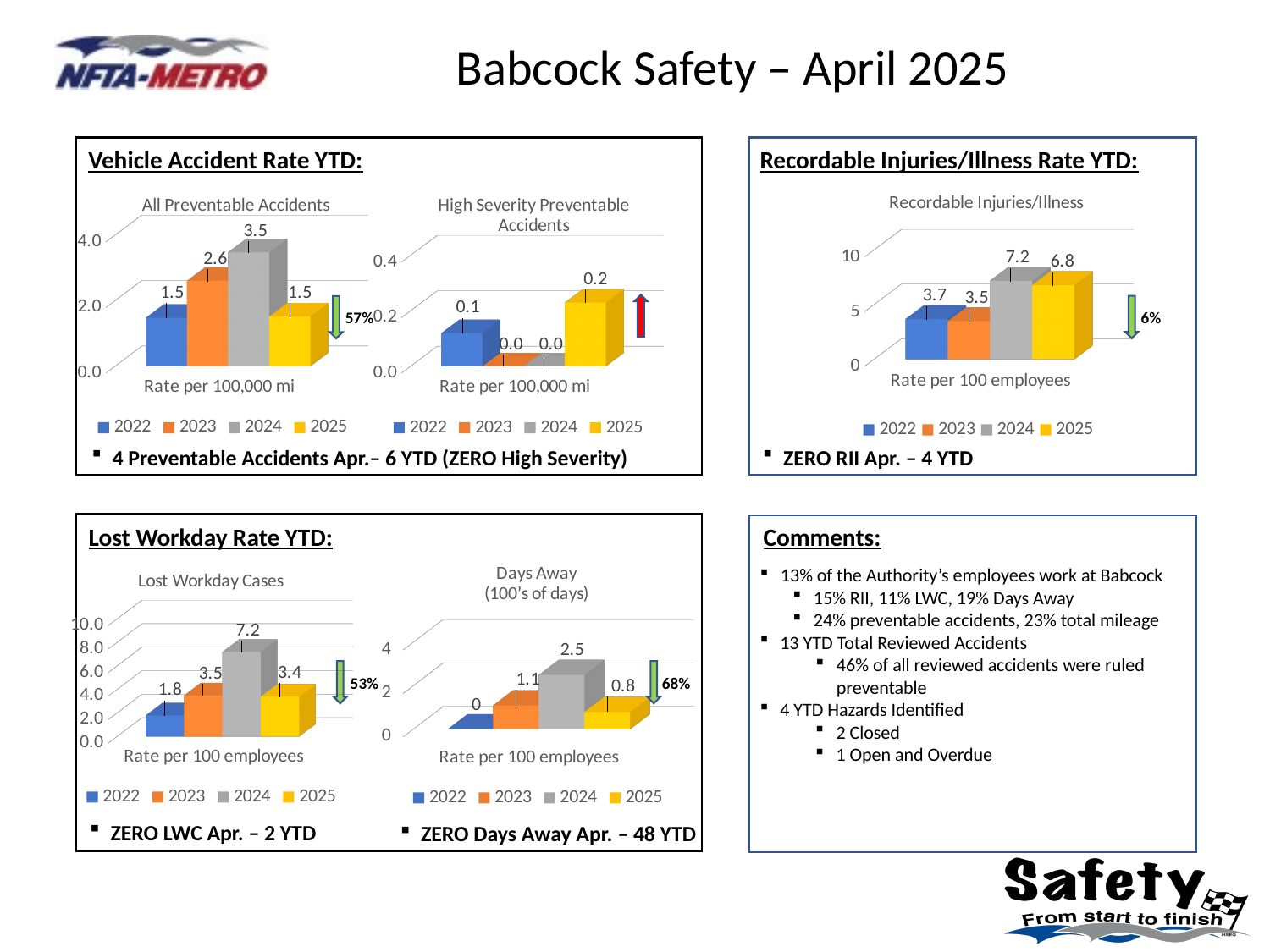
In the Days Away chart, what is the value for 2023? 1.1 What kind of chart is the Lost Workday Cases chart? Bar chart In the All Preventable Accidents chart, what is the value for 2024? 3.5 How many series does the legend of the Recordable Injuries/Illness chart list? 4 In the Lost Workday Cases chart, what is the difference between the 2024 and 2025 values? 3.8 In the Recordable Injuries/Illness chart, what is the difference between the 2024 and 2025 values? 0.4 In the Recordable Injuries/Illness chart, what is the value for 2023? 3.5 In the High Severity Preventable Accidents chart, what is the value for 2025? 0.2 In the Lost Workday Cases chart, which year has the lowest value? 2022 In the All Preventable Accidents chart, which year has the highest rate? 2024 In the Days Away chart, is the value for 2024 larger than the value for 2025? Yes In the High Severity Preventable Accidents chart, which year has the highest value? 2025